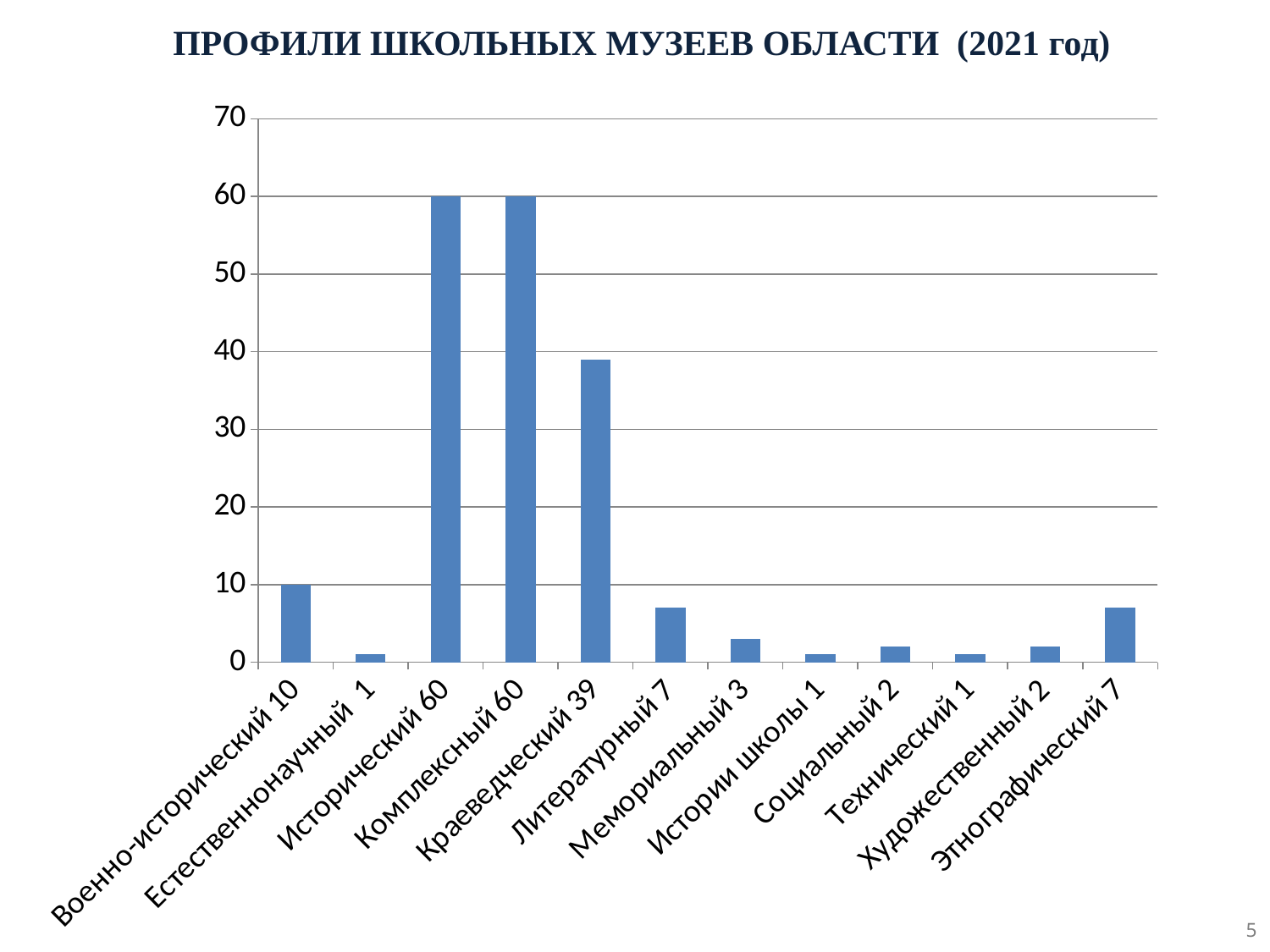
Is the value for Краеведческий greater or less than 40? less What is the difference between the values for Краеведческий and Военно-исторический? 29 What is the value for Краеведческий? 39 What kind of chart is shown on the slide? bar chart How many categories are shown in the chart? 12 What is the value for Военно-исторический? 10 What is the value for Мемориальный? 3 What is the value for Этнографический? 7 What is the difference between the values for Исторический and Краеведческий? 21 Which is larger, the value for Литературный or the value for Мемориальный? Литературный What is the highest value shown in the chart? 60 What is the title of the chart? ПРОФИЛИ ШКОЛЬНЫХ МУЗЕЕВ ОБЛАСТИ (2021 год)